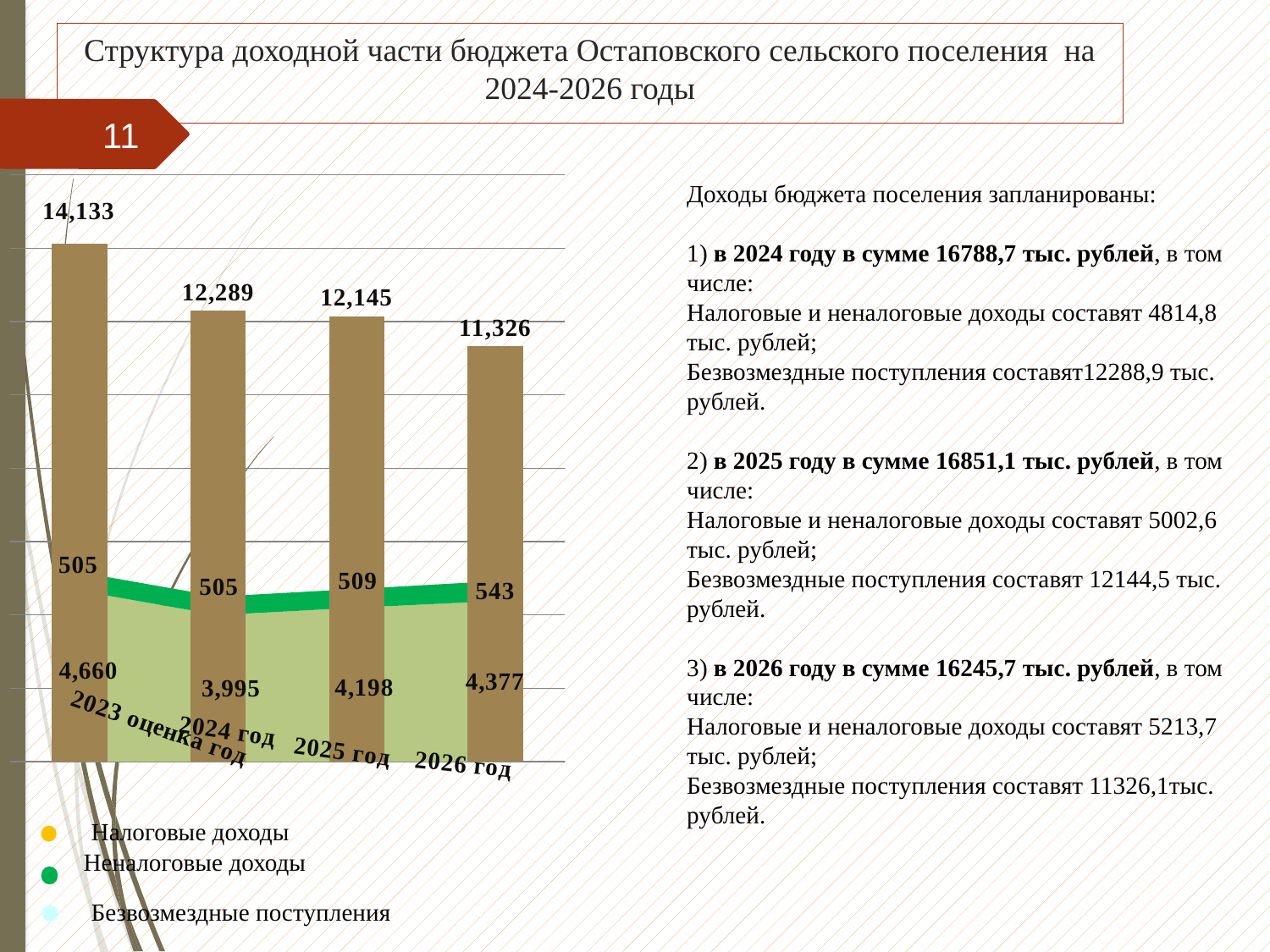
Do the tall bar values rise or fall from 2023 оценка год to 2026 год? fall What is the difference between the bar values for 2023 оценка год and 2024 год? 1,844 What is the value of the tall bar for 2024 год? 12,289 What value is labelled in the light green area for 2026 год? 4,377 Which category has the lowest bar value? 2026 год How many categories are shown on the x axis? 4 What is the value of the tall bar for 2026 год? 11,326 How many entries does the legend list? 3 What value is labelled in the dark green band for 2025 год? 509 Which is larger, the bar value for 2024 год or for 2025 год? 2024 год Which category has the highest bar value? 2023 оценка год What is the lowest value labelled in the light green area? 3,995